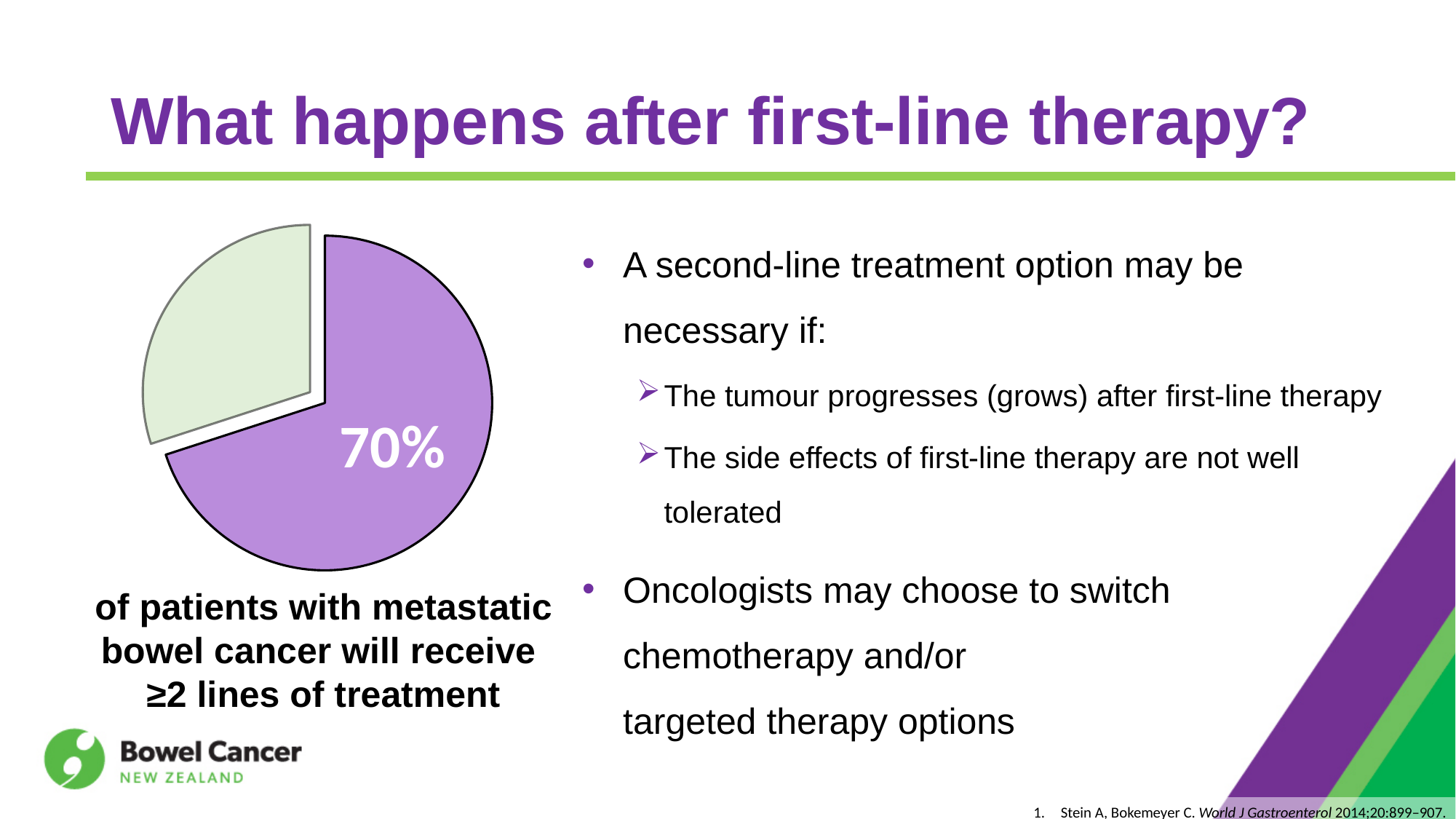
Which slice of the pie chart is larger, the purple slice or the pale green slice? The purple slice What kind of chart is shown on the slide? Pie chart What percentage is printed on the purple slice of the pie chart? 70% Is the pale green slice of the pie chart greater or less than 50% of the pie? less Is the purple slice of the pie chart greater or less than 50% of the pie? greater What colour is the slice of the pie chart labelled 70%? Purple What share of the pie does the purple slice represent? 70% According to the caption under the pie chart, what does the 70% slice represent? Patients with metastatic bowel cancer who will receive ≥2 lines of treatment How many slices does the pie chart have? 2